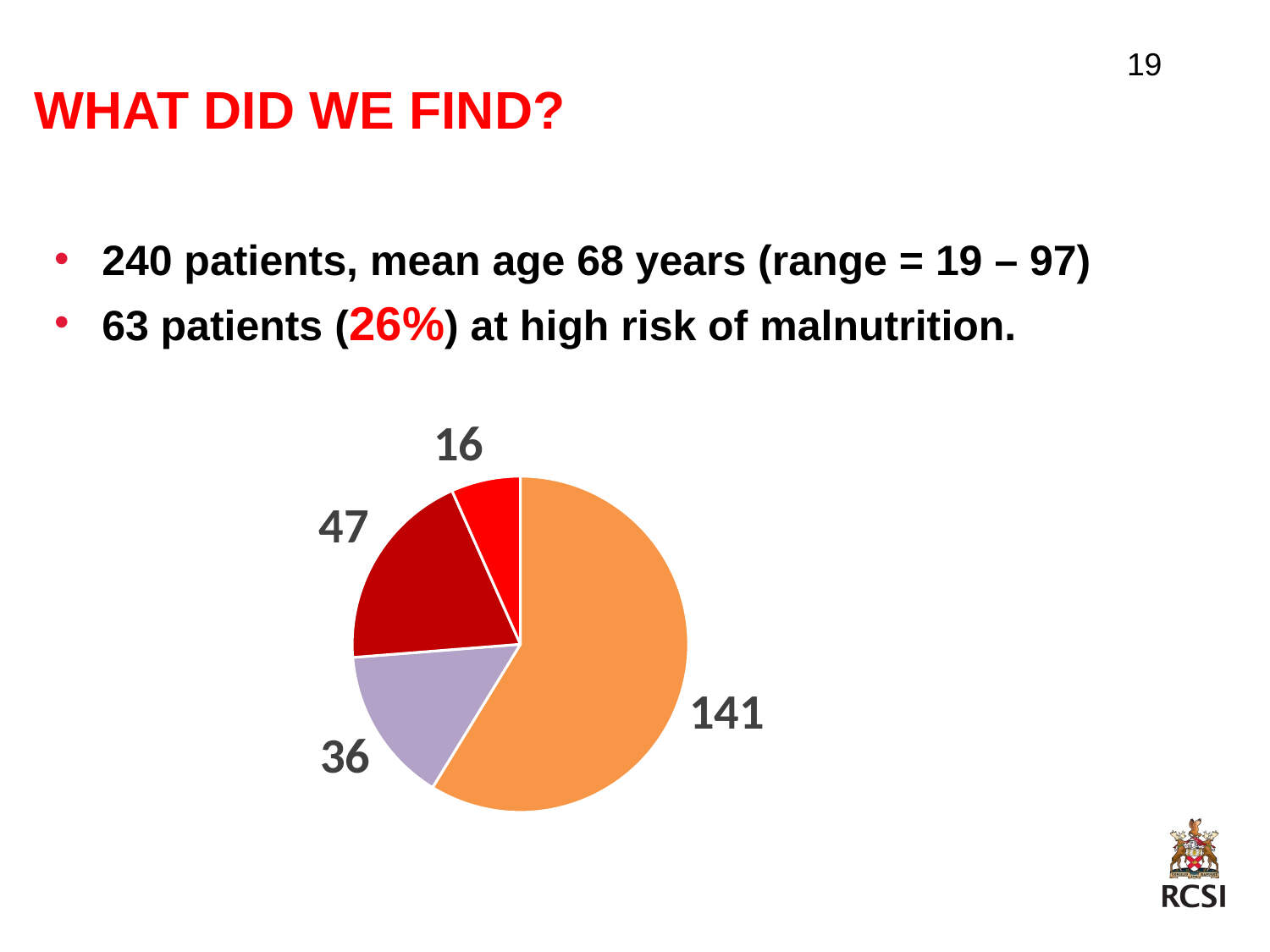
What value is shown for the light purple slice of the pie chart? 36 What kind of chart is shown on the slide? pie chart What is the value of the largest slice of the pie chart? 141 What is the difference between the largest slice (141) and the slice labelled 47? 94 How many slices does the pie chart have? 4 What is the value of the smallest slice of the pie chart? 16 Which is larger, the dark red slice or the light purple slice? dark red slice What is the total of all the slice values in the pie chart? 240 What value is shown for the orange slice of the pie chart? 141 What is the difference between the slices labelled 47 and 36? 11 What value is shown for the dark red slice of the pie chart? 47 What value is shown for the bright red slice of the pie chart? 16